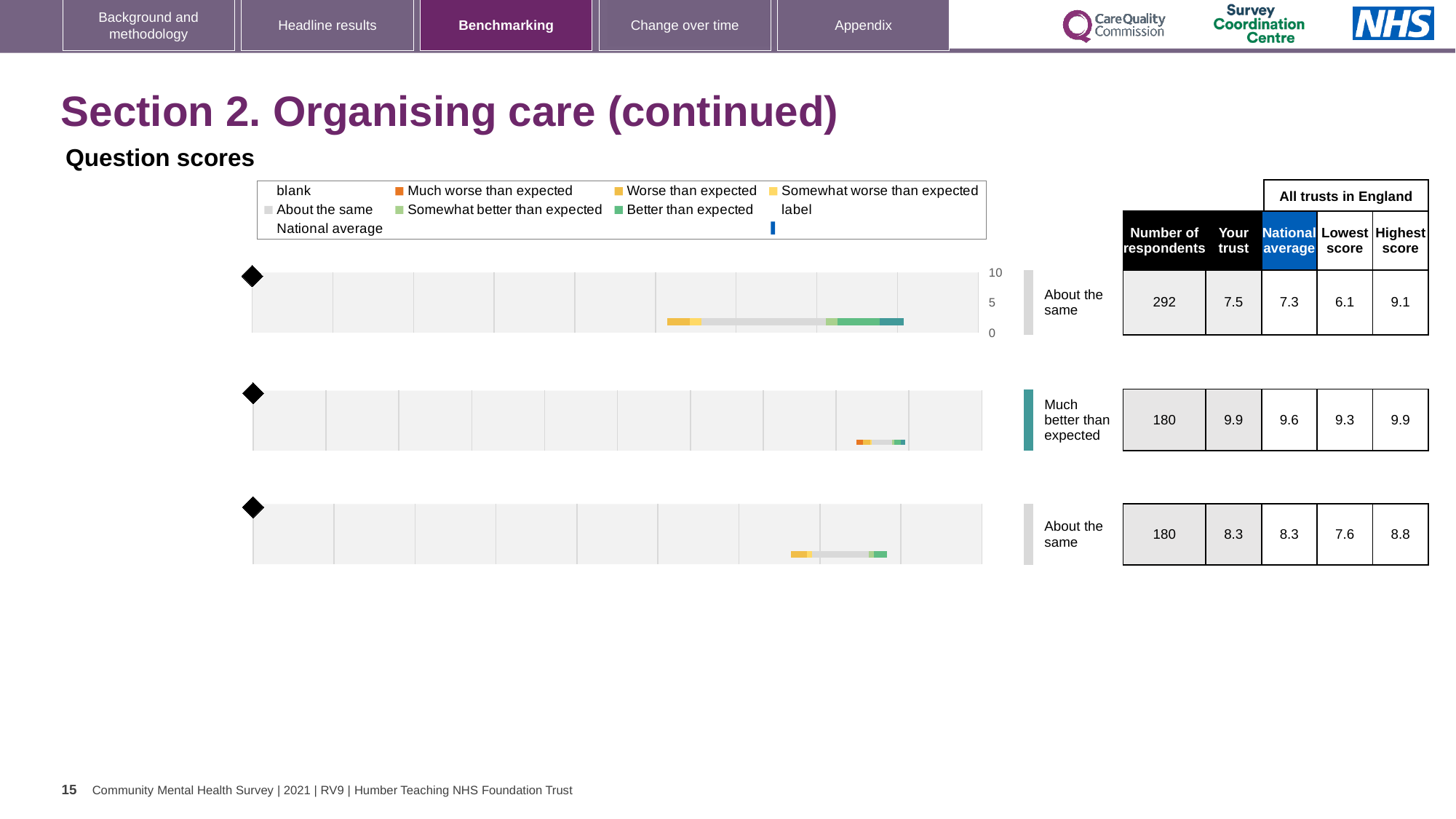
For the middle chart, what is the 'Your trust' score shown in the table? 9.9 For the middle chart, what is the highest score among all trusts in England? 9.9 Which of the three charts has the highest 'Your trust' score in the table? The middle chart (9.9) For the top chart, what is the national average score shown in the table? 7.3 For the top chart, how many respondents are listed in the table? 292 What kind of chart is used for the benchmarking displays on this slide? Bar chart For the top chart, what is the 'Your trust' score shown in the table? 7.5 For the bottom chart, what is the lowest score among all trusts in England? 7.6 For the top chart, what is the difference between the highest score (9.1) and the lowest score (6.1) in the table? 3.0 What benchmark category label is shown next to the middle chart? Much better than expected How many benchmarking charts are shown on the slide? 3 For the middle chart, which is larger: the 'Your trust' score or the national average? Your trust (9.9)